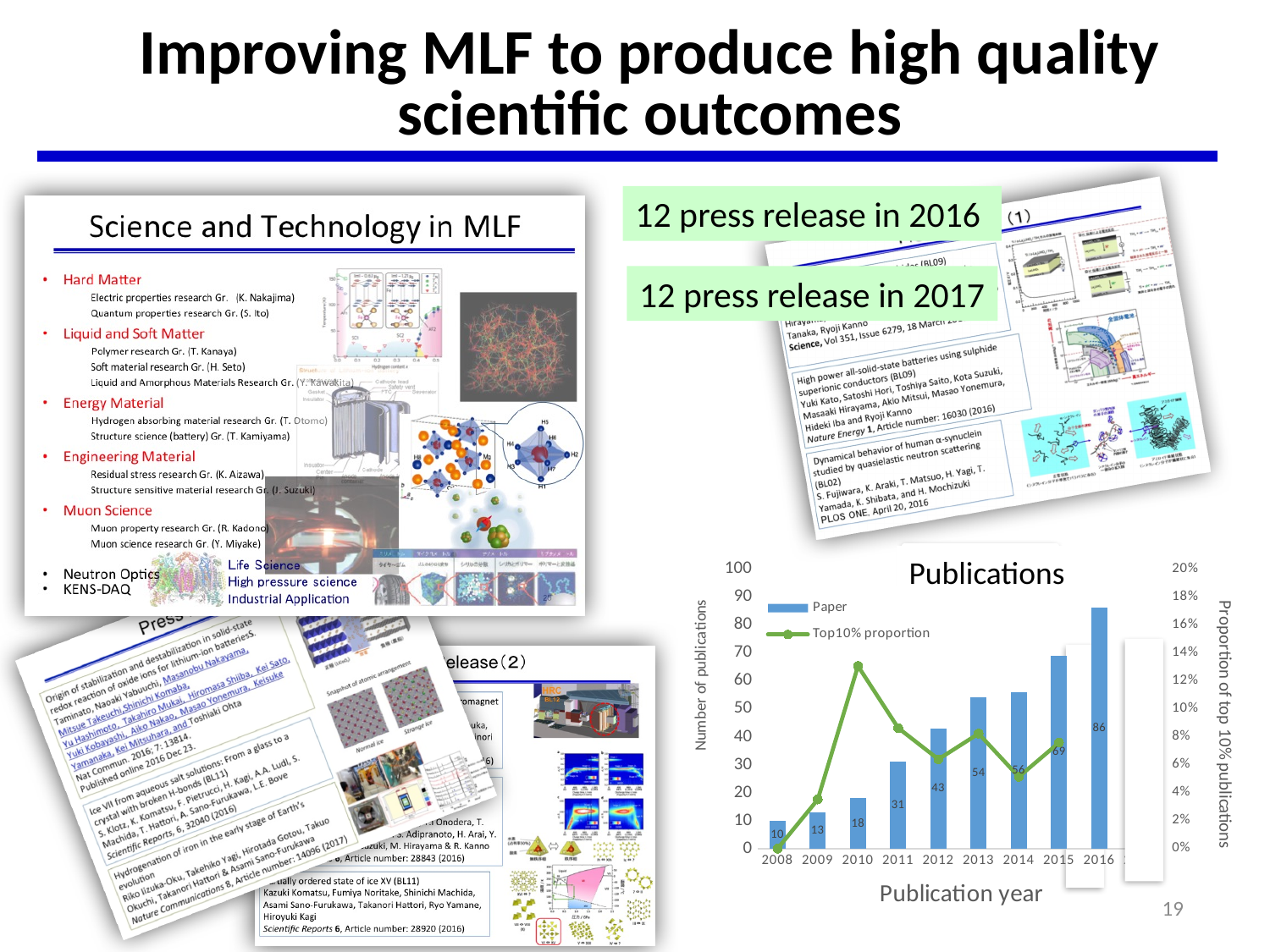
How many series does the legend of the Publications chart list? 2 In the Publications chart, is the Top10% proportion for 2010 greater or less than 10%? greater In the Publications chart, which publication year has the highest number of papers? 2016 In the Publications chart, which year had more papers, 2013 or 2011? 2013 In the Publications chart, how many papers were published in 2012? 43 In the Publications chart, which publication year has the lowest number of papers? 2008 What type of chart is used to show the number of publications? bar chart In the Publications chart, does the number of papers rise or fall from 2008 to 2016? rise What is the title of the chart on the slide? Publications In the Publications chart, how many papers were published in 2016? 86 In the Publications chart, what is the difference in the number of papers between 2016 and 2015? 17